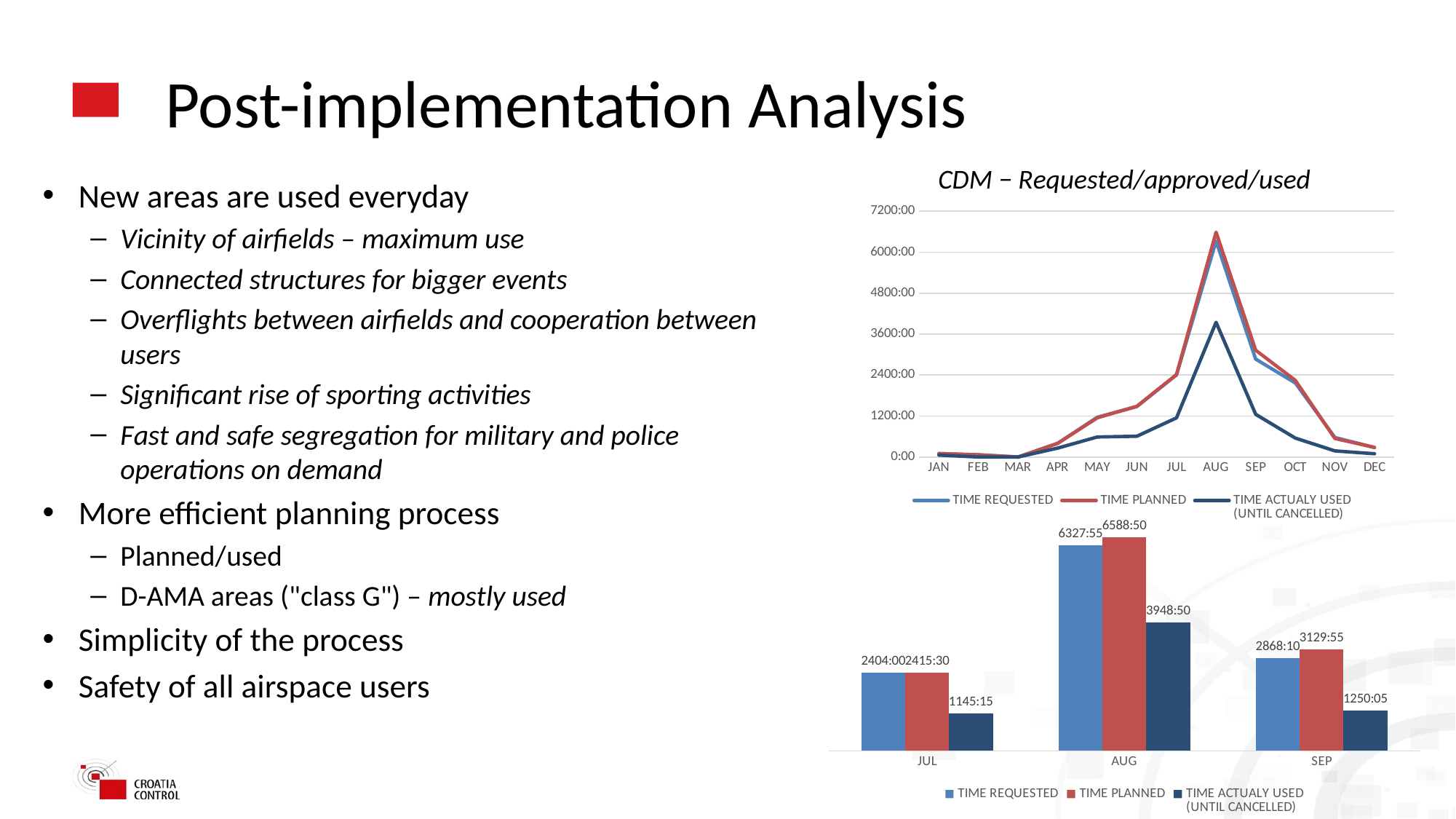
In the bottom bar chart, what is the TIME REQUESTED value for SEP? 2868:10 In the bottom bar chart, which is larger for SEP: TIME REQUESTED or TIME PLANNED? TIME PLANNED In the bottom bar chart, which month has the lowest TIME ACTUALY USED (UNTIL CANCELLED) value? JUL How many series does the legend of the top line chart list? 3 How many months are shown on the x axis of the bottom bar chart? 3 In the bottom bar chart, which month has the highest TIME REQUESTED value? AUG In the top line chart, is the TIME PLANNED value for AUG greater or less than 6000:00? greater In the bottom bar chart, what is the TIME PLANNED value for AUG? 6588:50 What kind of chart is the top chart titled 'CDM – Requested/approved/used'? line chart In the top line chart, is the TIME ACTUALY USED (UNTIL CANCELLED) value for MAR greater or less than 1200:00? less What kind of chart is the bottom chart on the slide? bar chart In the bottom bar chart, what is the TIME ACTUALY USED (UNTIL CANCELLED) value for JUL? 1145:15